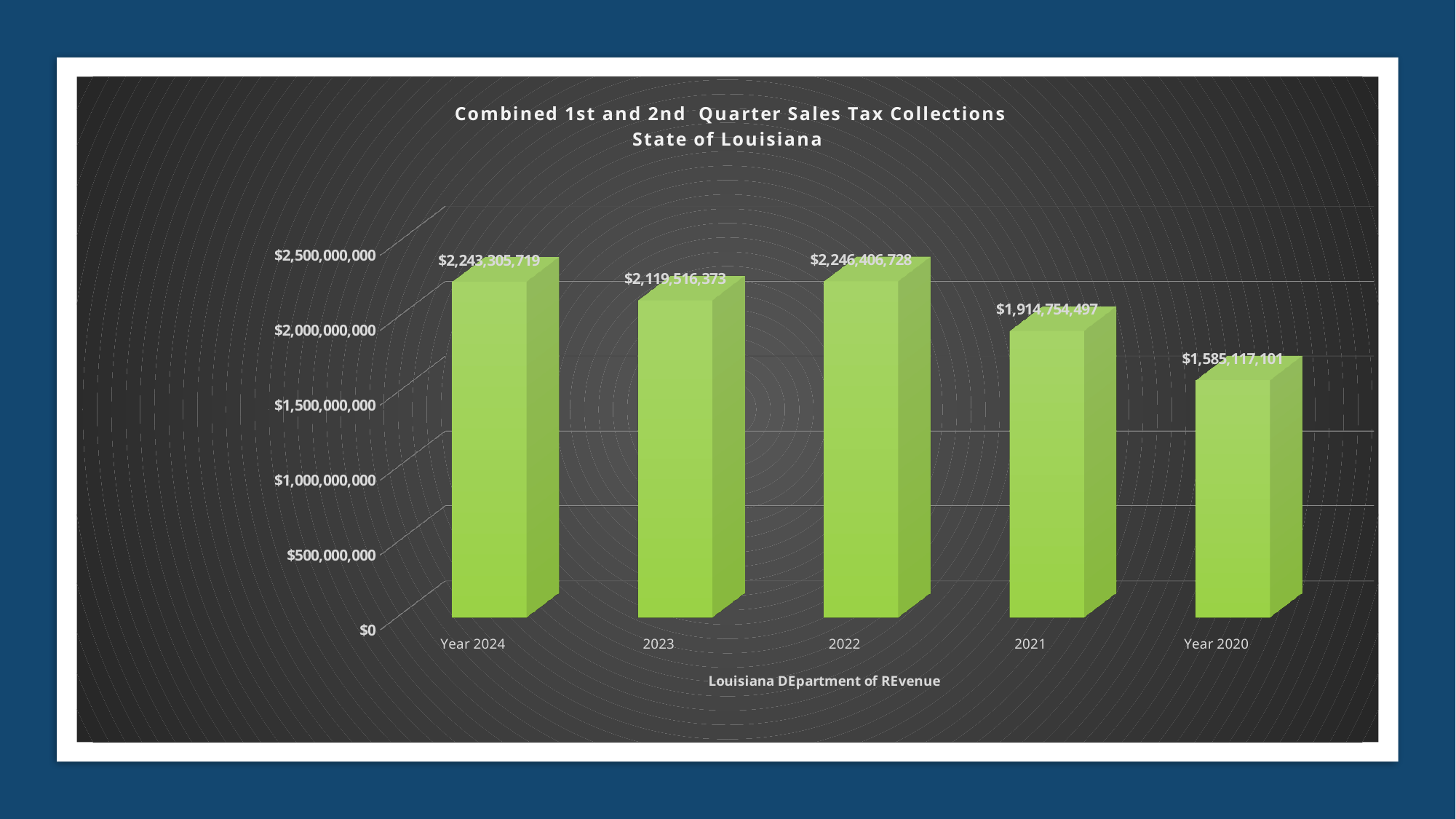
What is the value for Year 2020? $1,585,117,101 What is the value for 2022? $2,246,406,728 Which is larger, the value for 2023 or the value for 2021? 2023 Which year has the lowest sales tax collections? Year 2020 What is the value for 2023? $2,119,516,373 What is the value for Year 2024? $2,243,305,719 Which year has the highest sales tax collections? 2022 What is the difference between the values for 2021 and Year 2020? $329,637,396 How many years are shown on the chart? 5 What kind of chart is shown on the slide? Bar chart What is the difference between the values for Year 2024 and 2023? $123,789,346 What is the value for 2021? $1,914,754,497